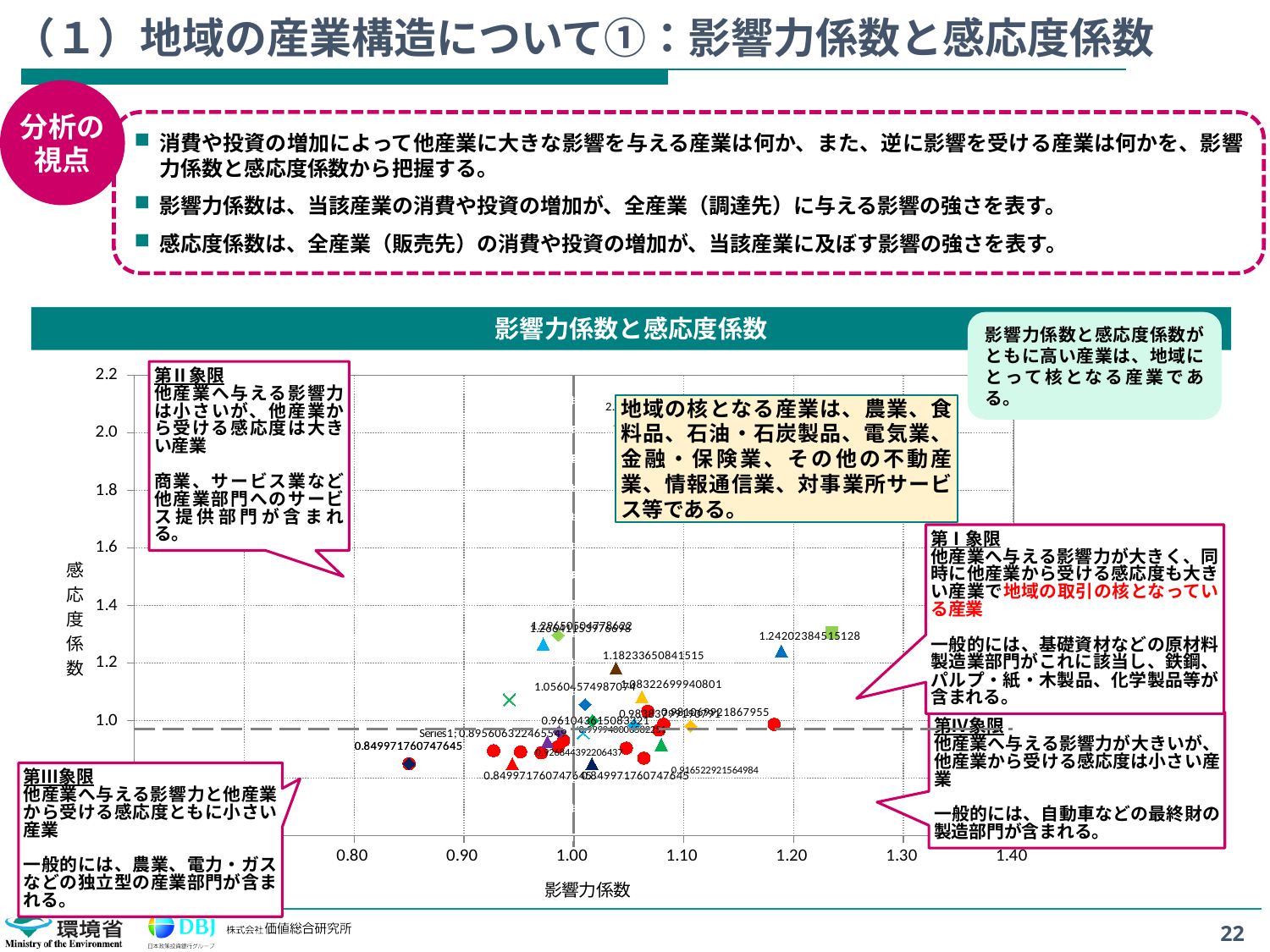
For the point labelled 1.24202384515128, is its 影響力係数 (x-axis) value greater or less than 1.10? greater What data label is printed on the point at the far left of the chart, near x = 0.85? 0.849971760747645 What is the title of the horizontal axis of the chart? 影響力係数 For the point labelled 0.849971760747645 at the far left of the chart, is its 影響力係数 (x-axis) value greater or less than 0.90? less What kind of chart is shown on the slide? scatter chart What data label is printed on the point at the far right of the chart, near x = 1.19? 1.24202384515128 For the point labelled 1.18233650841515, is its 感応度係数 (y-axis) value greater or less than 1.0? greater What is the title of the chart? 影響力係数と感応度係数